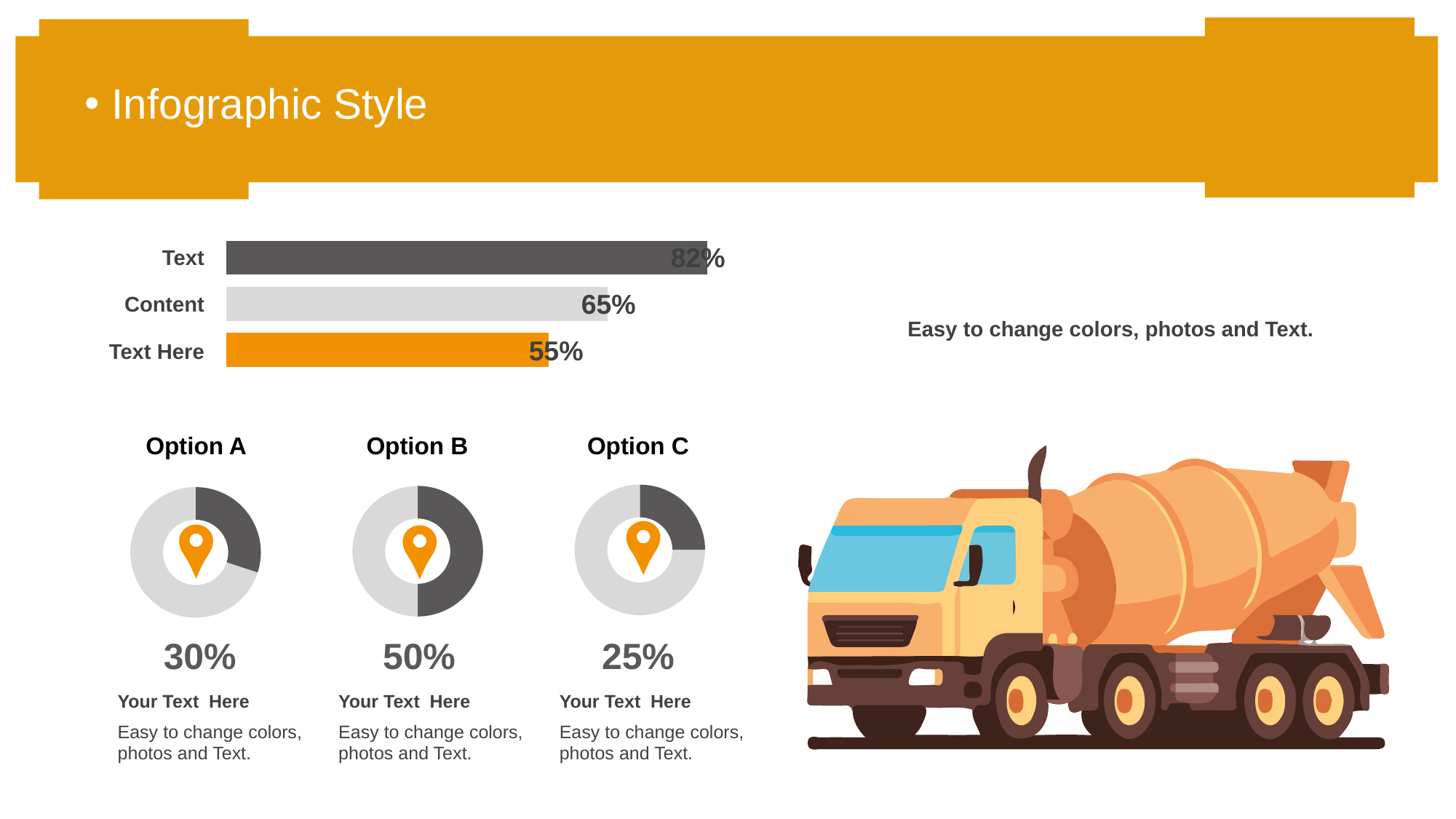
In the horizontal bar chart at the top left, what colour is the bar for Text Here? Orange In the horizontal bar chart at the top left, what is the value for Text Here? 55% How many categories does the horizontal bar chart at the top left show? 3 In the horizontal bar chart at the top left, what is the difference between the values for Text and Content? 17% In the horizontal bar chart at the top left, what is the value for Content? 65% In the donut chart labelled Option B, what percentage is shown? 50% In the horizontal bar chart at the top left, which is larger, the value for Content or the value for Text Here? Content In the horizontal bar chart at the top left, which category has the lowest value? Text Here What is the difference between the percentages shown for Option A and Option C? 5% What kind of chart is shown at the top left of the slide? Bar chart Among the donut charts Option A, Option B and Option C, which shows the lowest percentage? Option C In the horizontal bar chart at the top left, which category has the highest value? Text